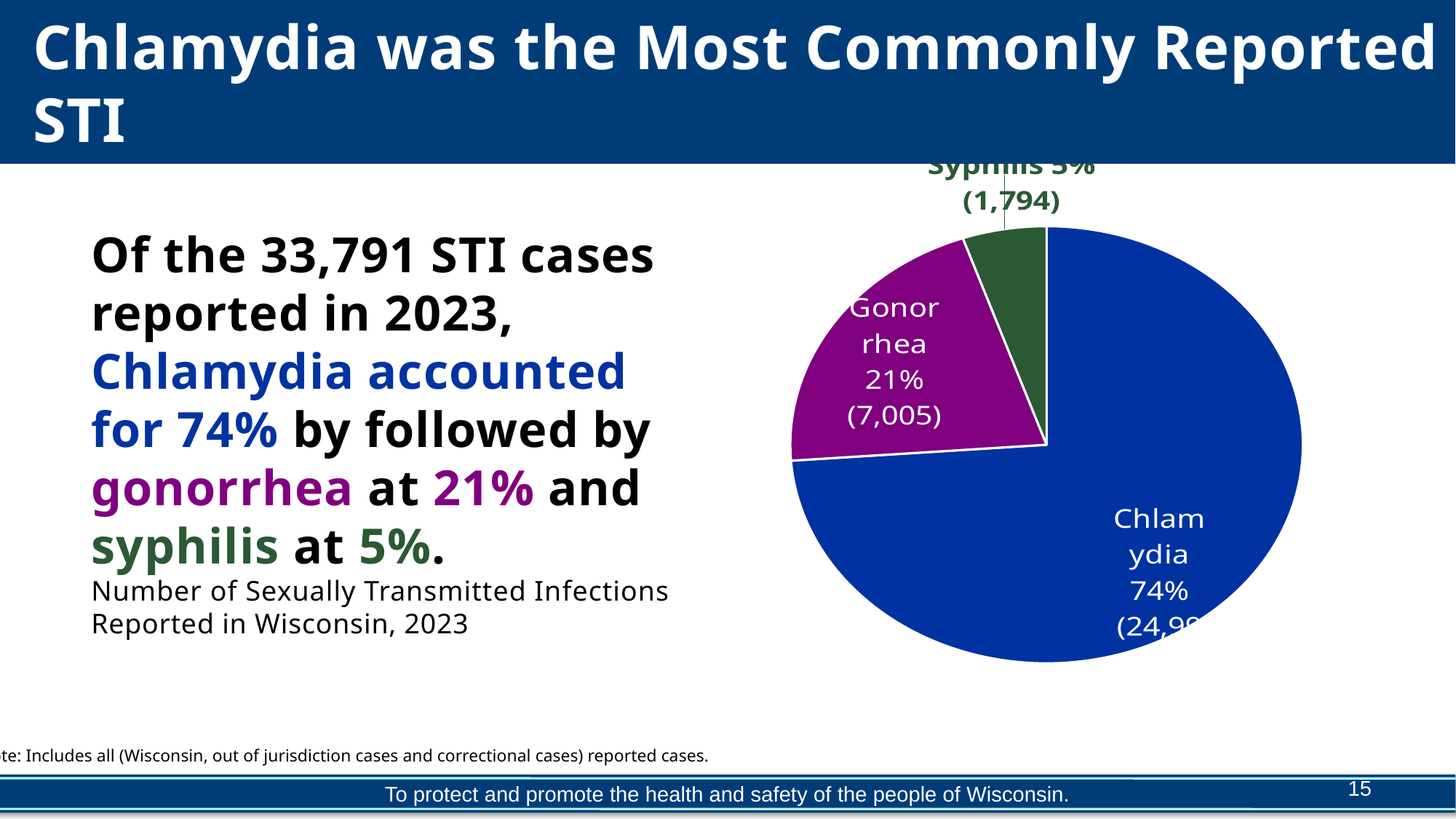
Which STI has the largest slice of the pie? Chlamydia What share of the pie does Gonorrhea account for? 21% How many Syphilis cases are shown in the pie chart? 1,794 Which has more reported cases, Gonorrhea or Syphilis? Gonorrhea Which STI has the smallest slice of the pie? Syphilis How many more Gonorrhea cases than Syphilis cases are shown in the pie chart? 5,211 What kind of chart is shown on the slide? pie chart What colour is the Gonorrhea slice of the pie? purple How many Gonorrhea cases are shown in the pie chart? 7,005 What share of the pie does Syphilis account for? 5% What share of the pie does Chlamydia account for? 74% How many slices does the pie chart have? 3